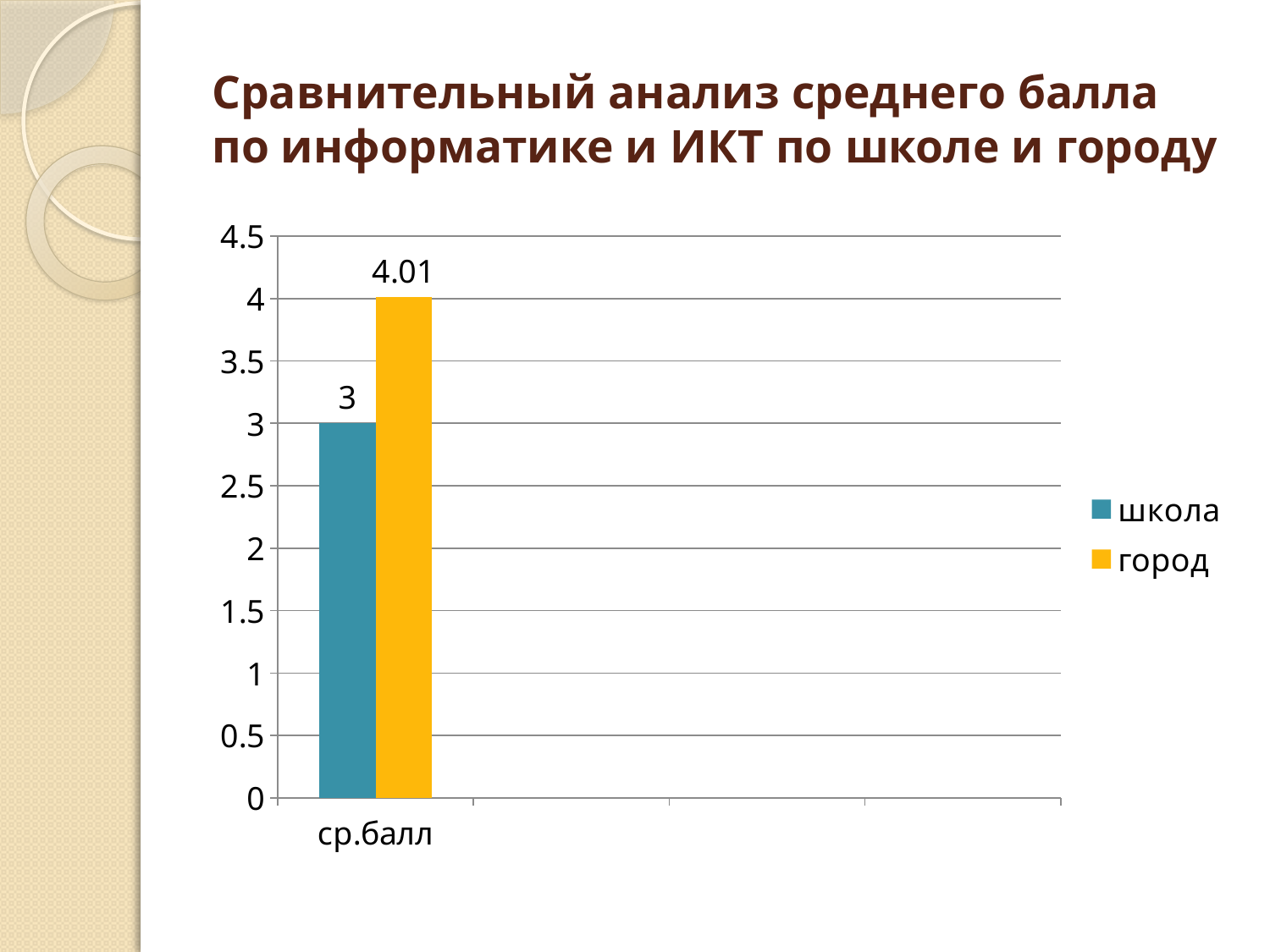
What is the difference between the город and школа values for ср.балл? 1.01 What is the value for школа in the ср.балл category? 3 Is the value for школа greater or less than 3.5? less What colour is the bar for город? yellow What kind of chart is shown on the slide? bar chart Is the value for город greater or less than 3.5? greater What is the value for город in the ср.балл category? 4.01 What is the highest value shown on the y axis? 4.5 Which series has the higher value for ср.балл, школа or город? город How many categories are shown on the x axis? 1 What is the label of the category on the x axis? ср.балл How many series does the legend list? 2